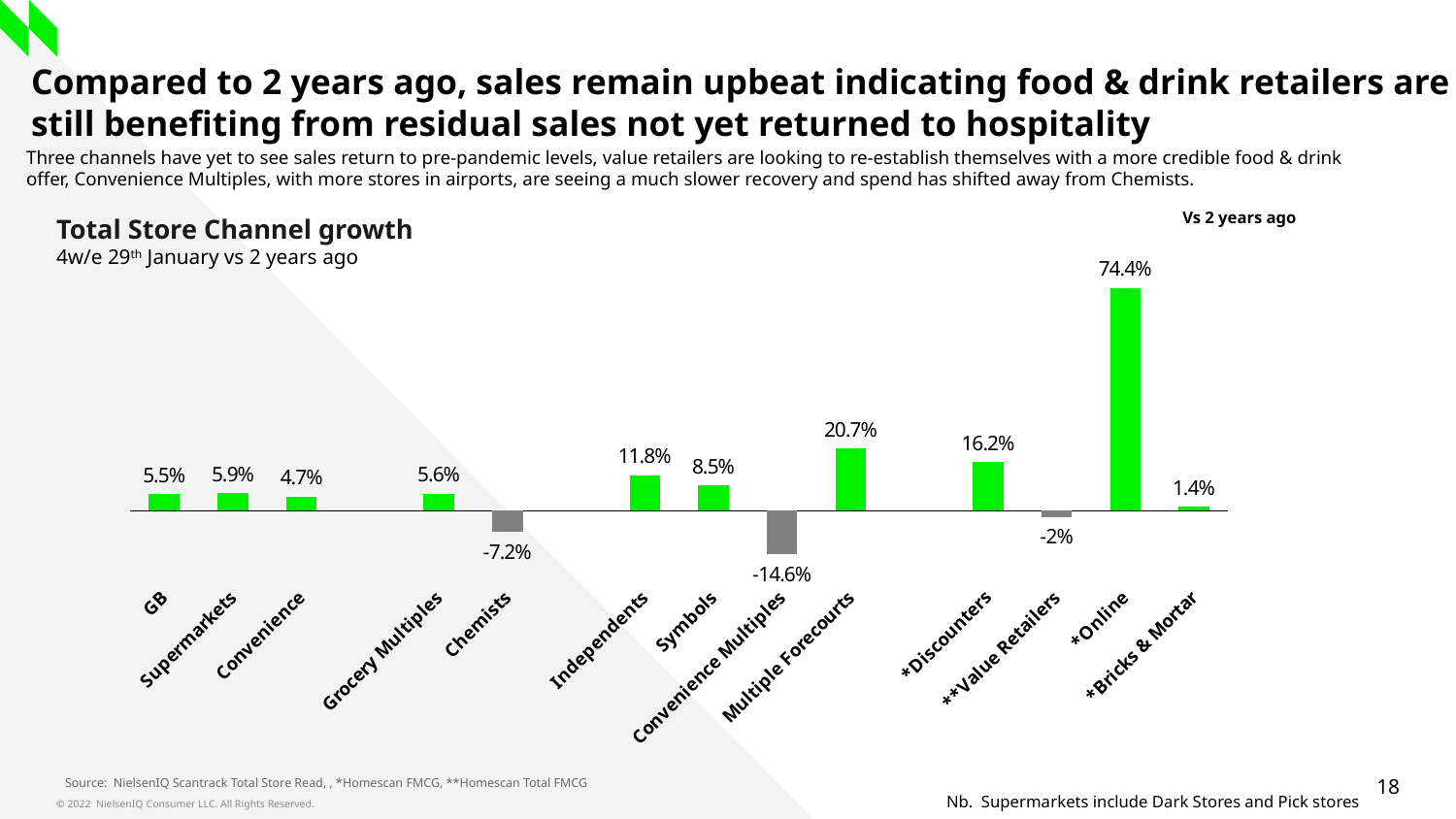
Which channel has the highest growth value? *Online Which has a larger growth value, Symbols or Supermarkets? Symbols What is the title of the chart? Total Store Channel growth What is the growth value for *Online? 74.4% How many channels are plotted on the chart? 13 What is the growth value for Multiple Forecourts? 20.7% Which channel has the lowest growth value? Convenience Multiples What is the difference between the growth values for *Discounters and Independents? 4.4% What is the growth value for Chemists? -7.2% What kind of chart is shown on the slide? Bar chart What colour are the bars with negative values? Grey What is the growth value for Convenience Multiples? -14.6%